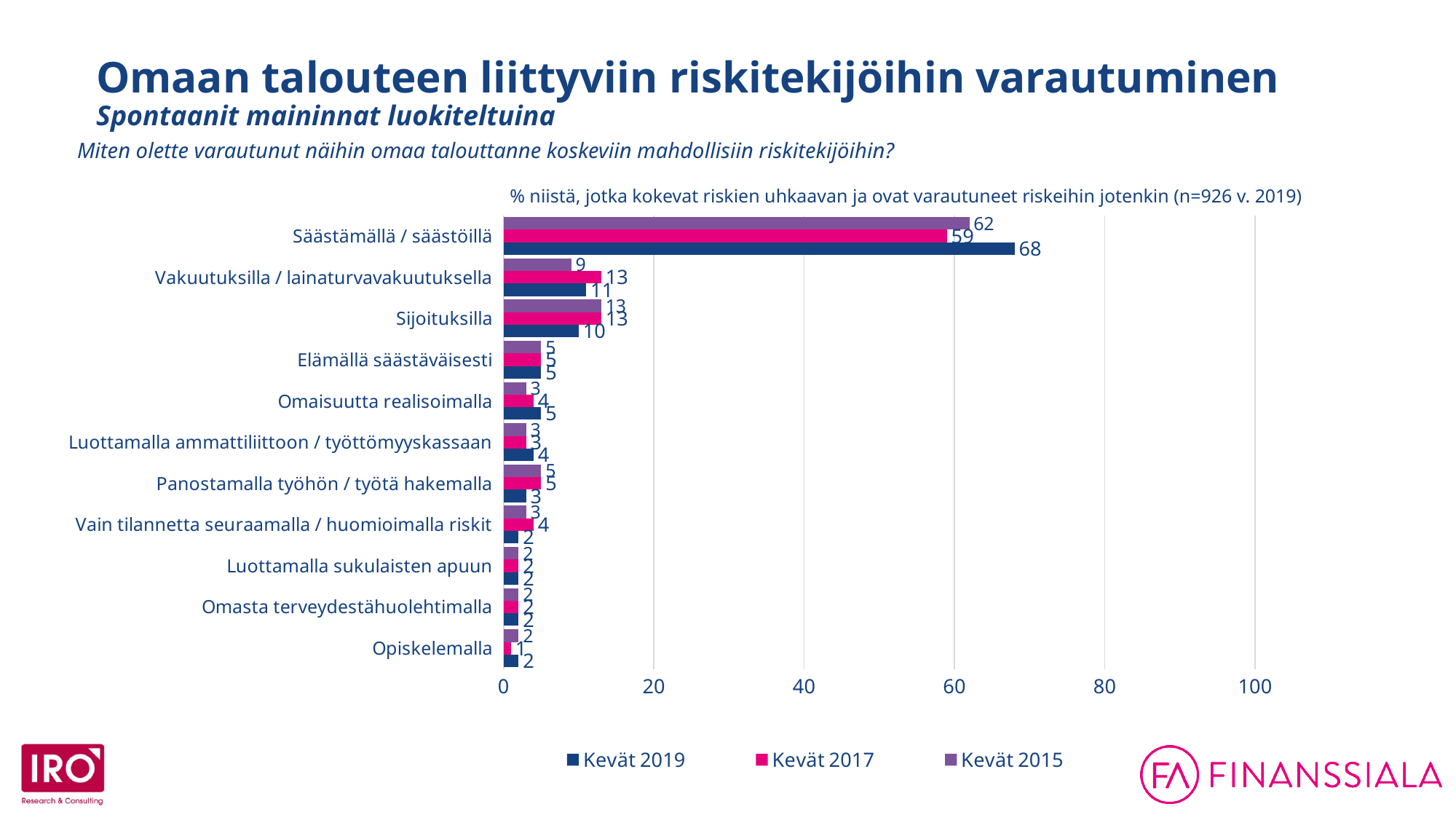
What is the difference between the Kevät 2019 and Kevät 2015 values for Säästämällä / säästöillä? 6 How many series does the legend list? 3 What is the Kevät 2015 value for Vakuutuksilla / lainaturvavakuutuksella? 9 Which category has the highest Kevät 2019 value? Säästämällä / säästöillä Is the Kevät 2019 value for Säästämällä / säästöillä greater or less than 60? greater Which is larger for Vakuutuksilla / lainaturvavakuutuksella: the Kevät 2017 value or the Kevät 2019 value? Kevät 2017 What is the Kevät 2019 value for Säästämällä / säästöillä? 68 What is the Kevät 2017 value for Säästämällä / säästöillä? 59 What is the Kevät 2017 value for Opiskelemalla? 1 How many categories are shown on the chart? 11 What kind of chart is shown on the slide? Bar chart What is the Kevät 2019 value for Sijoituksilla? 10